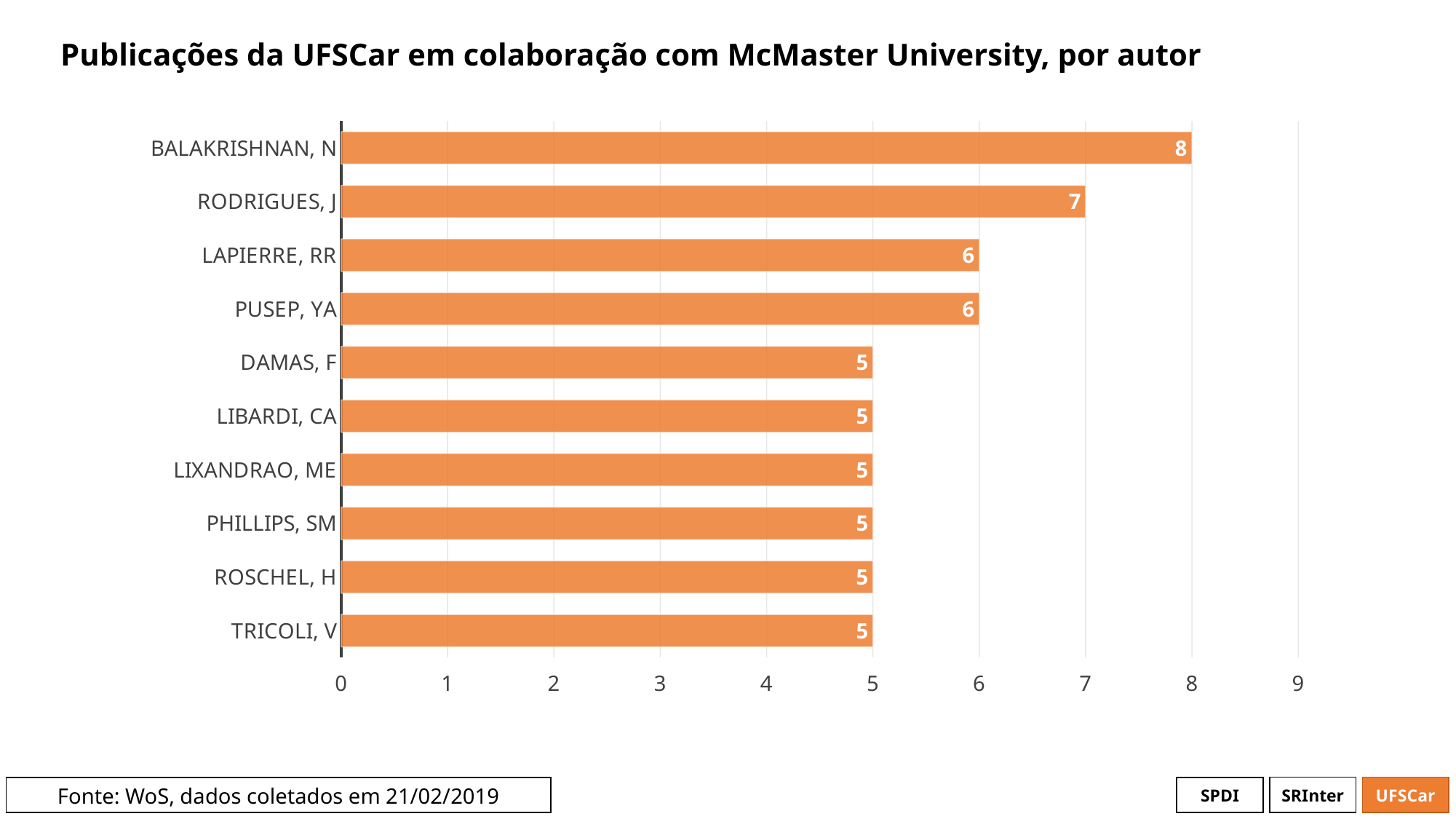
How many authors are shown in the chart? 10 What is the value for RODRIGUES, J? 7 What is the difference between the values for BALAKRISHNAN, N and RODRIGUES, J? 1 What is the value for TRICOLI, V? 5 What kind of chart is shown on the slide? bar chart What is the value for LAPIERRE, RR? 6 Which author has the highest number of publications? BALAKRISHNAN, N What is the title of the chart? Publicações da UFSCar em colaboração com McMaster University, por autor Is the value for BALAKRISHNAN, N greater or less than 7? greater Which is larger, the value for PUSEP, YA or the value for LIBARDI, CA? PUSEP, YA What is the difference between the values for RODRIGUES, J and DAMAS, F? 2 How many publications does BALAKRISHNAN, N have? 8